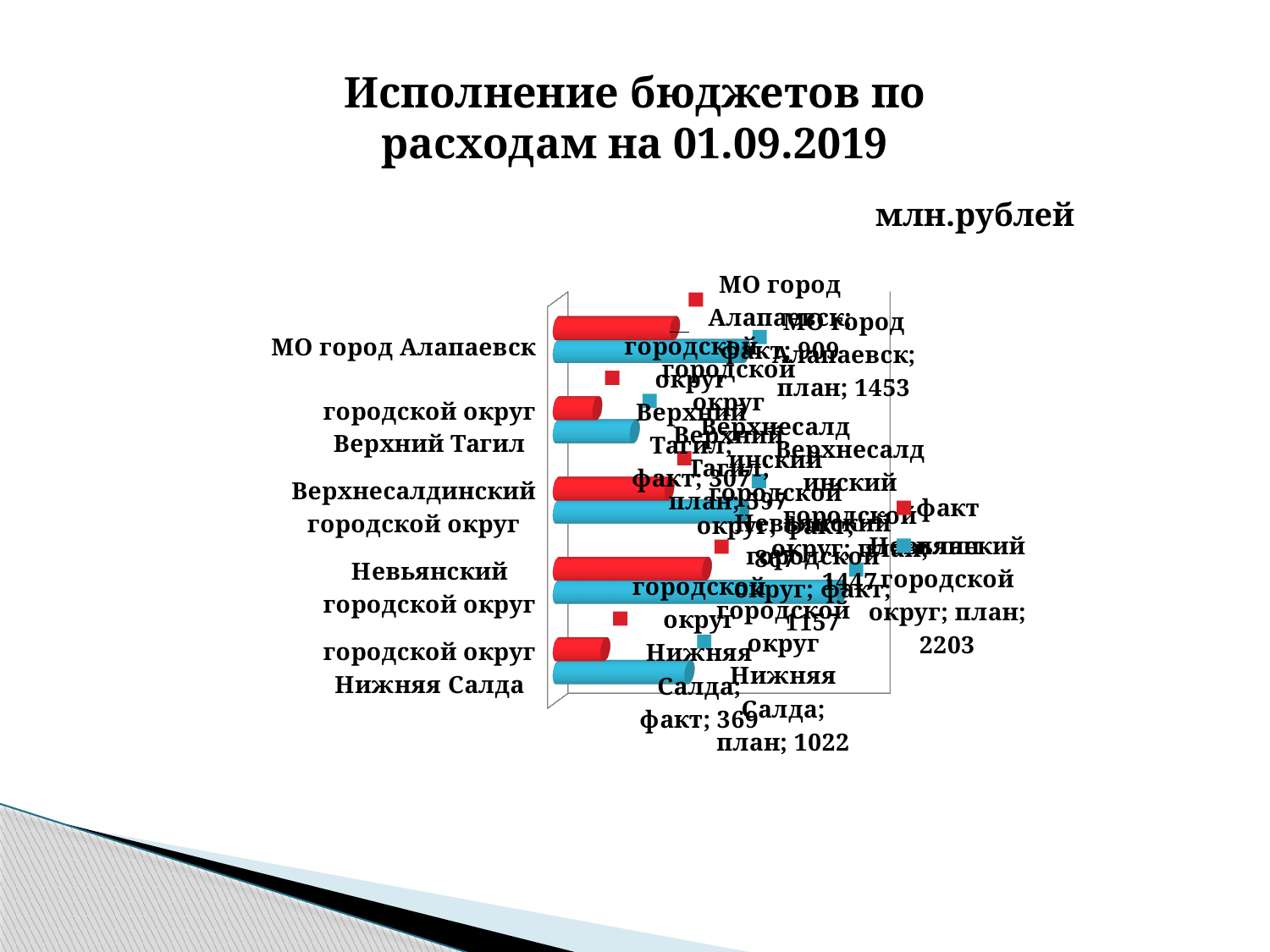
Which has the larger план value: Невьянский городской округ or МО город Алапаевск? Невьянский городской округ What is the план value for Невьянский городской округ? 2203 What kind of chart is shown on the slide? bar chart How many data series does the chart plot for each municipality? 2 What is the difference between план and факт for городской округ Верхний Тагил? 290 In what units are the values on the chart expressed? млн.рублей What is the план value for городской округ Нижняя Салда? 1022 What is the difference between план and факт for городской округ Нижняя Салда? 653 What is the план value for МО город Алапаевск? 1453 What is the факт value for городской округ Верхний Тагил? 307 What is the факт value for городской округ Нижняя Салда? 369 How many municipalities (categories) are shown on the chart? 5